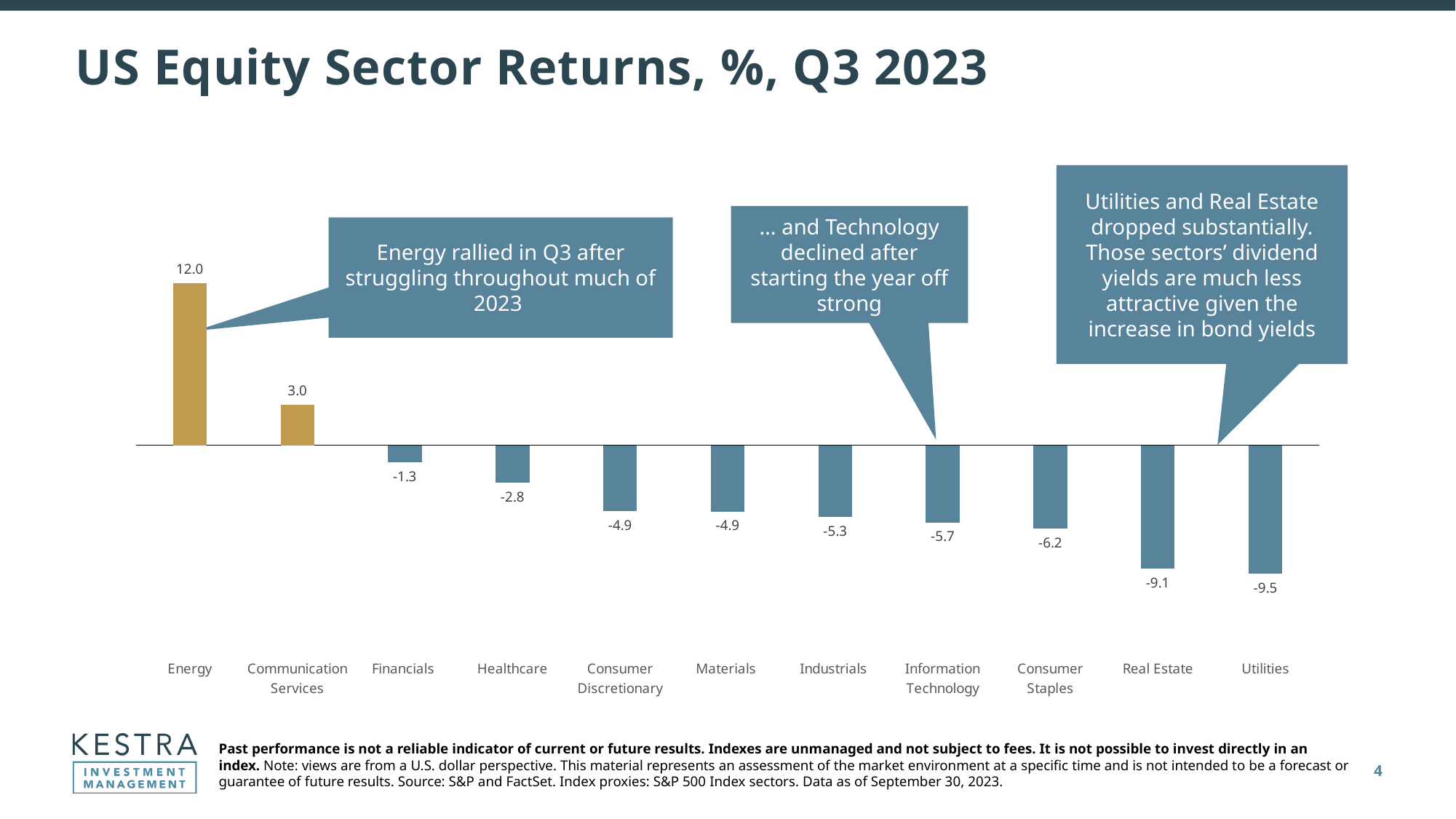
What is the Q3 2023 return for Information Technology? -5.7 What colour are the bars for the sectors with positive returns? Gold Which sector has the highest return in Q3 2023? Energy What kind of chart is shown on the slide? Bar chart How many sectors are shown on the chart? 11 Which sector has the lowest return in Q3 2023? Utilities How many sectors have a positive return in Q3 2023? 2 What is the difference between the Energy return and the Communication Services return? 9.0 What is the Q3 2023 return for Real Estate? -9.1 Which sector has the larger return, Financials or Healthcare? Financials What is the difference between the Utilities return and the Real Estate return? 0.4 What is the Q3 2023 return for Energy? 12.0